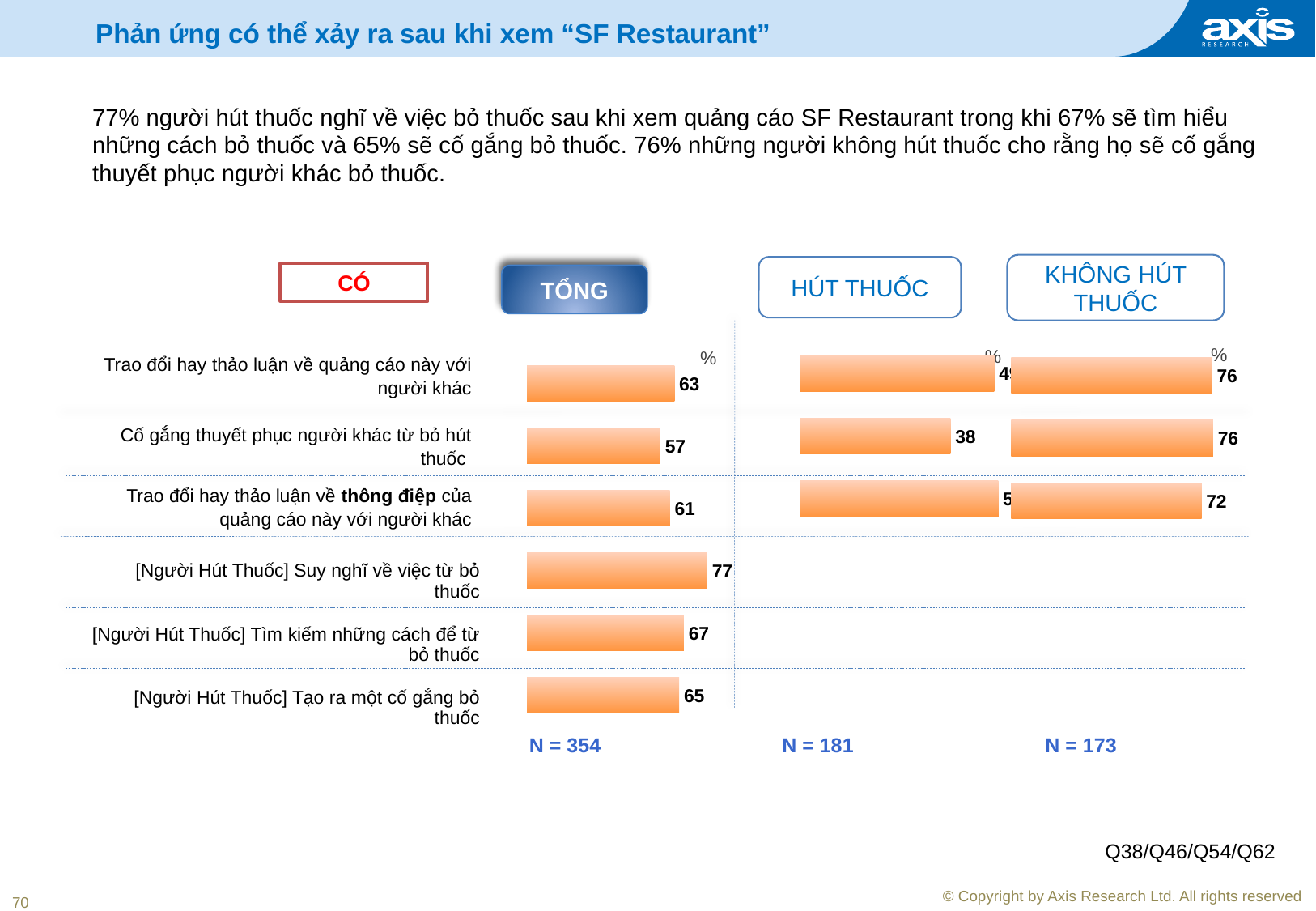
What kind of chart is used on this slide? Bar chart In the TỔNG chart, which category has the highest value? [Người Hút Thuốc] Suy nghĩ về việc từ bỏ thuốc How many categories are plotted in the TỔNG chart? 6 In the TỔNG chart, which category has the lowest value? Cố gắng thuyết phục người khác từ bỏ hút thuốc In the TỔNG chart, what is the value for "Trao đổi hay thảo luận về quảng cáo này với người khác"? 63 In the HÚT THUỐC chart, what is the value for "Cố gắng thuyết phục người khác từ bỏ hút thuốc"? 38 In the KHÔNG HÚT THUỐC chart, what is the value for "Cố gắng thuyết phục người khác từ bỏ hút thuốc"? 76 In the TỔNG chart, what is the value for "[Người Hút Thuốc] Suy nghĩ về việc từ bỏ thuốc"? 77 In the TỔNG chart, what is the difference between "[Người Hút Thuốc] Suy nghĩ về việc từ bỏ thuốc" and "[Người Hút Thuốc] Tạo ra một cố gắng bỏ thuốc"? 12 In the KHÔNG HÚT THUỐC chart, what is the value for "Trao đổi hay thảo luận về thông điệp của quảng cáo này với người khác"? 72 In the TỔNG chart, what is the value for "Cố gắng thuyết phục người khác từ bỏ hút thuốc"? 57 For "Cố gắng thuyết phục người khác từ bỏ hút thuốc", which is larger: the HÚT THUỐC value or the KHÔNG HÚT THUỐC value? KHÔNG HÚT THUỐC